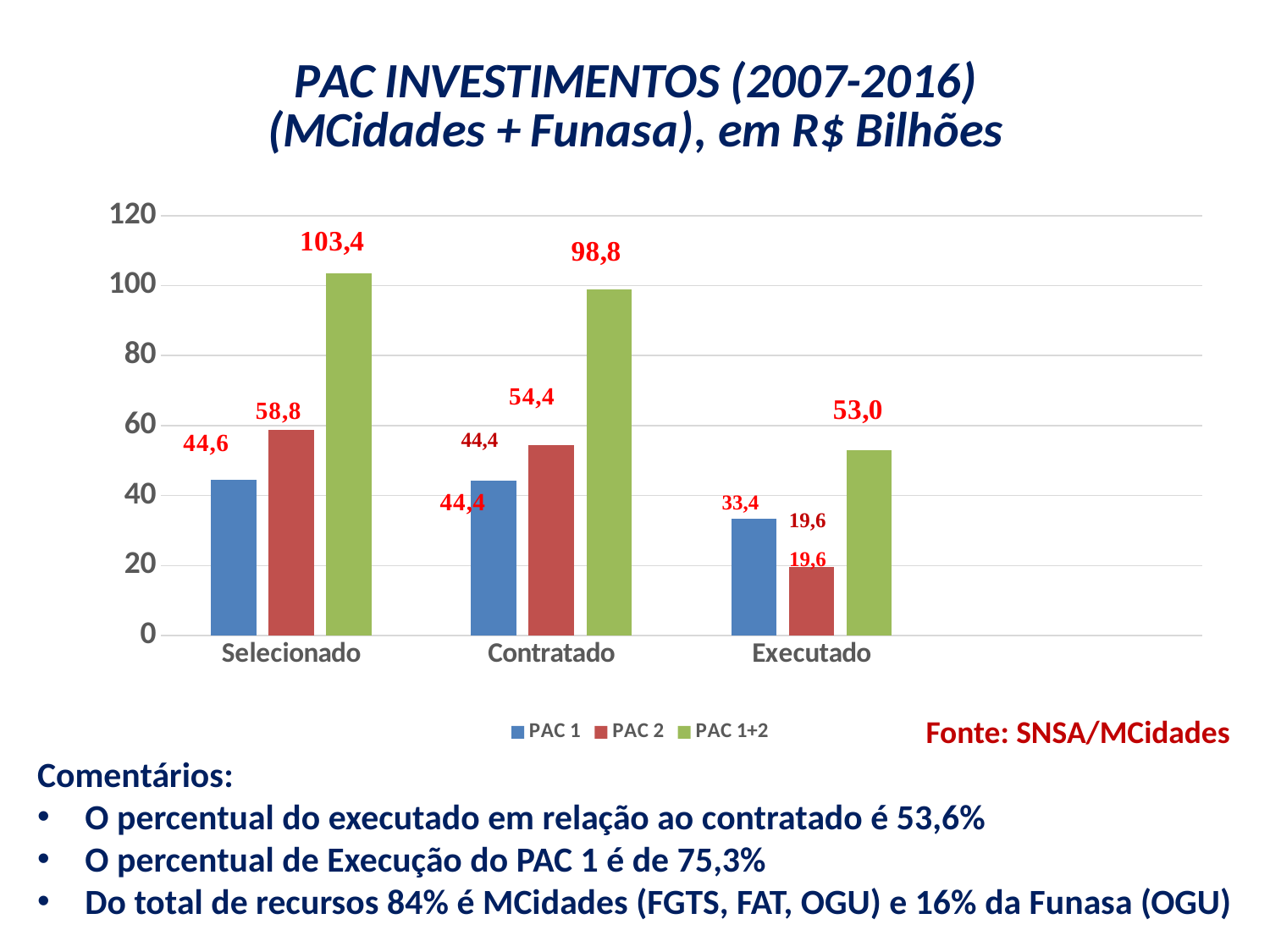
What is the difference between the PAC 1+2 values for Selecionado and Contratado? 4,6 Which category has the lowest PAC 2 value? Executado Which category has the highest PAC 1+2 value? Selecionado Which is larger in the Executado category, PAC 1 or PAC 2? PAC 1 What is the value for PAC 1+2 in the Selecionado category? 103,4 How many categories are shown on the x axis? 3 What is the source cited for the chart? SNSA/MCidades Is the value for PAC 1+2 in the Executado category greater or less than 60? less What is the value for PAC 2 in the Contratado category? 54,4 How many series does the legend list? 3 What kind of chart is shown on the slide? bar chart What is the value for PAC 1 in the Executado category? 33,4